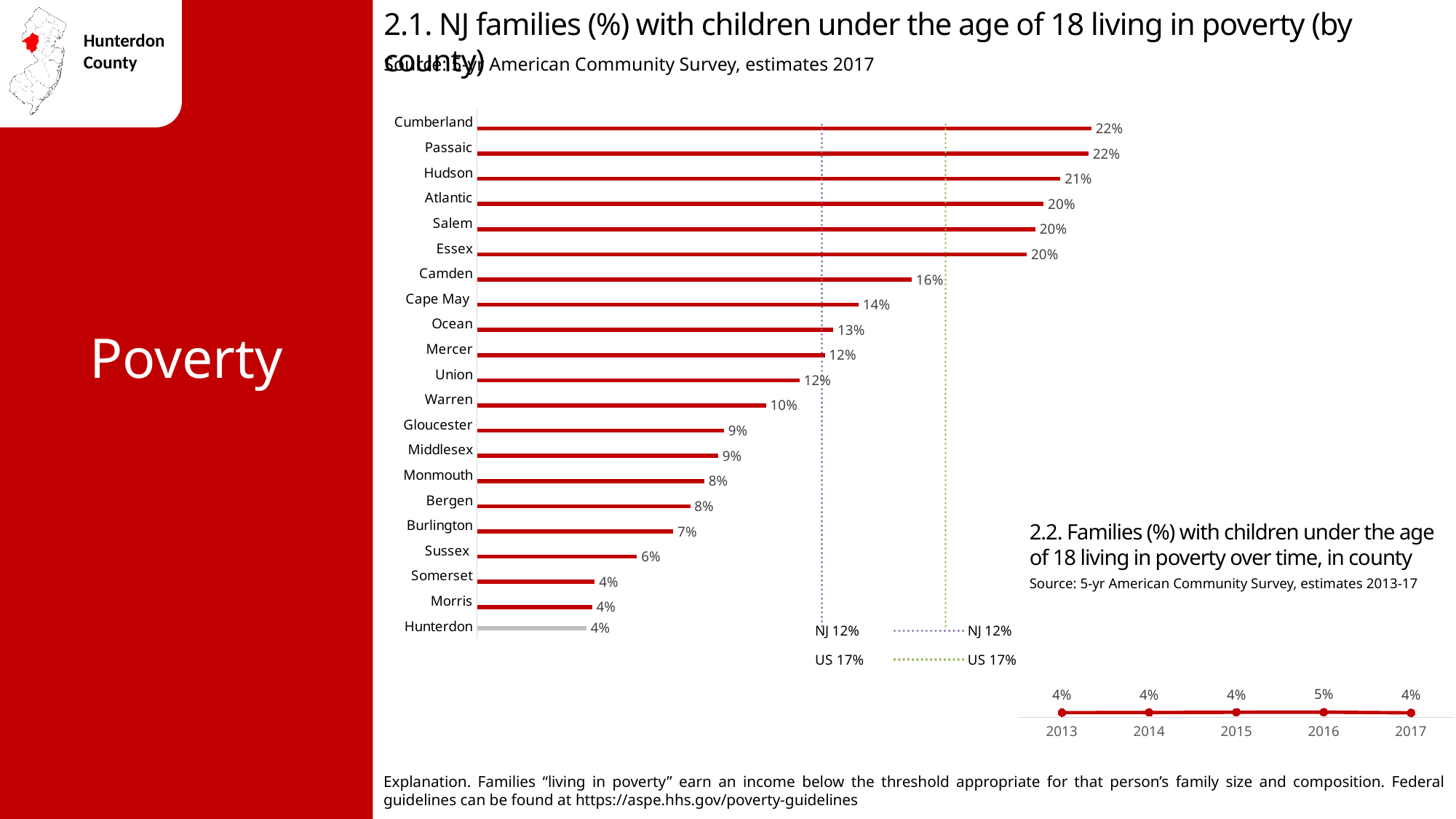
In chart 2.1, which has a higher value, Hudson or Warren? Hudson In chart 2.1, what is the US reference value marked by the dotted line? 17% In chart 2.2, what is the difference between the values for 2016 and 2017? 1% What kind of chart is chart 2.1? Bar chart In chart 2.1, how many counties are plotted? 21 In chart 2.1, what is the value shown for Camden? 16% In chart 2.2, how many years are plotted? 5 In chart 2.2, what is the value for 2016? 5% In chart 2.1, what percentage of families with children under 18 live in poverty in Hunterdon County? 4% In chart 2.1, what is the NJ reference value marked by the dotted line? 12% In chart 2.1, what is the difference between the values for Cumberland and Hunterdon? 18% In chart 2.1, what is the value shown for Cape May? 14%